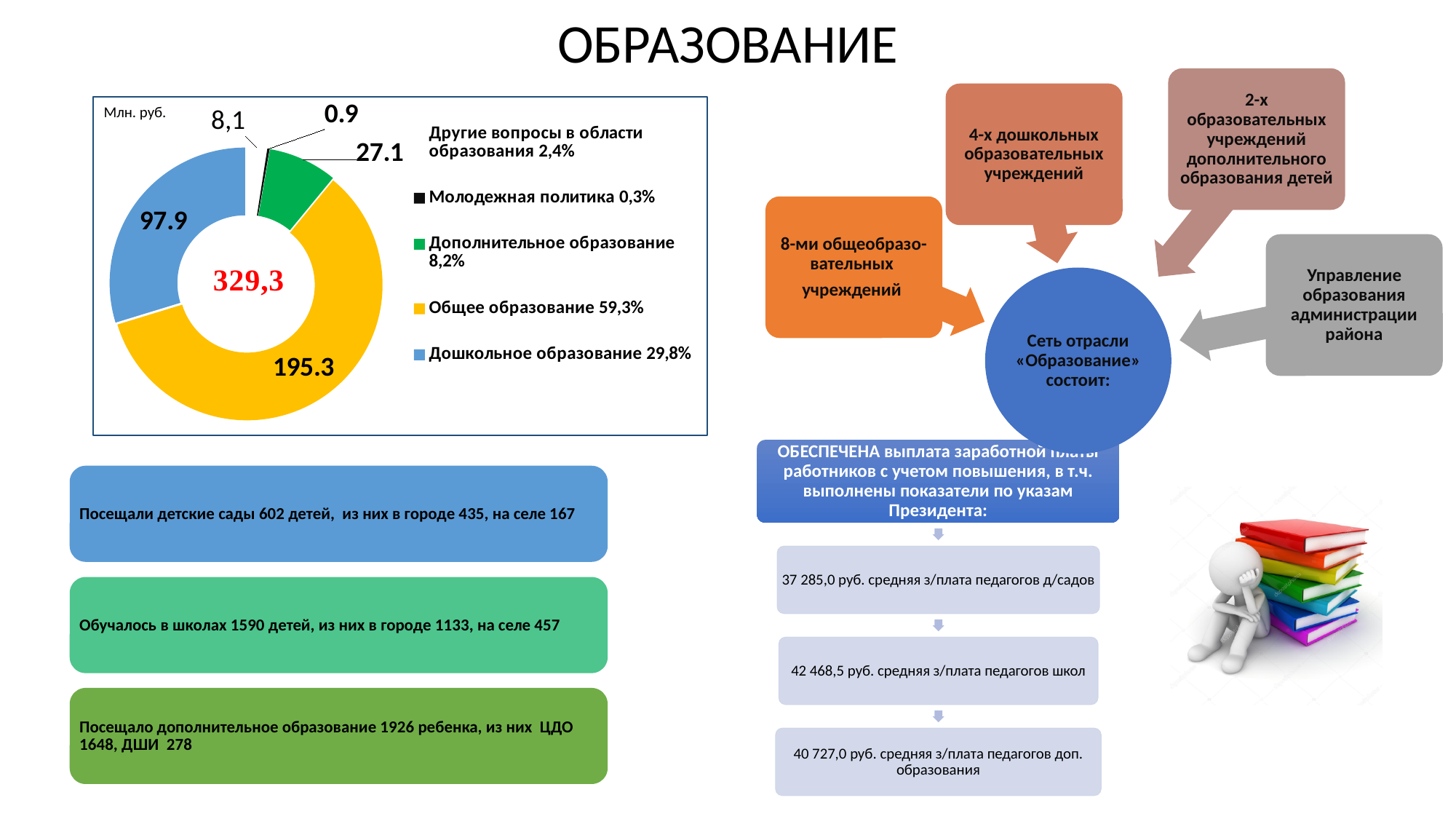
What total value is printed in the centre of the doughnut chart? 329,3 What is the value for Молодежная политика in the doughnut chart? 0.9 What share of the doughnut chart does Дошкольное образование represent, according to the legend? 29,8% How many categories does the legend of the doughnut chart list? 5 What kind of chart is shown on the left of the slide? doughnut (pie) chart What share of the doughnut chart does Общее образование represent, according to the legend? 59,3% Which is larger in the doughnut chart: Дошкольное образование or Дополнительное образование? Дошкольное образование Which category has the largest slice in the doughnut chart? Общее образование What is the value for Общее образование in the doughnut chart? 195.3 Which category has the smallest slice in the doughnut chart? Молодежная политика What is the value for Дополнительное образование in the doughnut chart? 27.1 What is the value for Дошкольное образование in the doughnut chart? 97.9